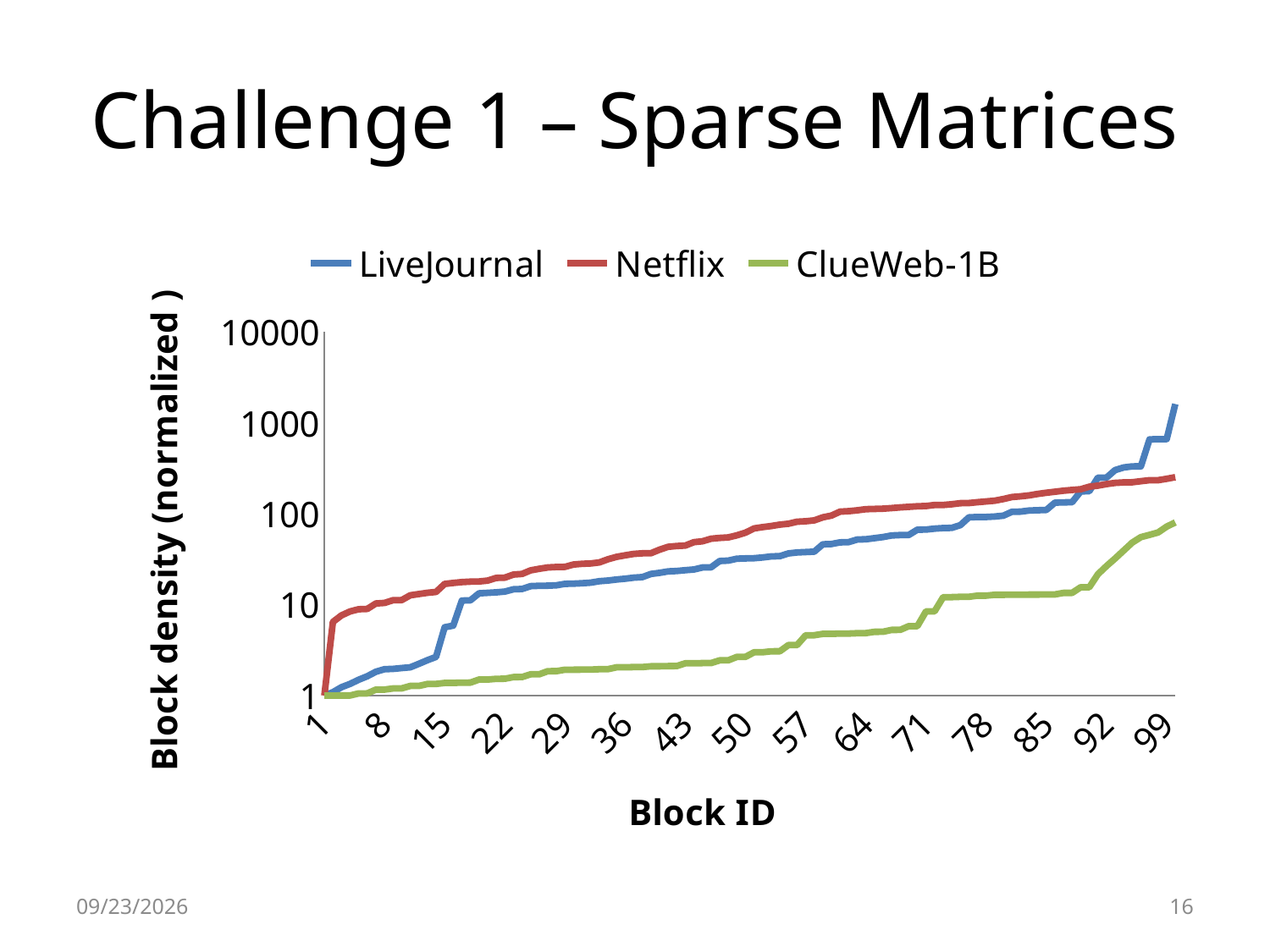
How many series does the legend list? 3 Do the values for ClueWeb-1B rise or fall as Block ID increases? rise Which series are listed in the legend? LiveJournal, Netflix, ClueWeb-1B Is the value for ClueWeb-1B at Block ID 50 greater or less than 10? less Is the value for Netflix at Block ID 50 greater or less than 10? greater At Block ID 50, which series has the higher value, Netflix or LiveJournal? Netflix At Block ID 99, which series has the higher value, LiveJournal or ClueWeb-1B? LiveJournal Is the value for LiveJournal at Block ID 92 greater or less than 100? greater What is the label of the x axis? Block ID What kind of chart is shown on the slide? line chart Do the values for Netflix rise or fall as Block ID increases? rise